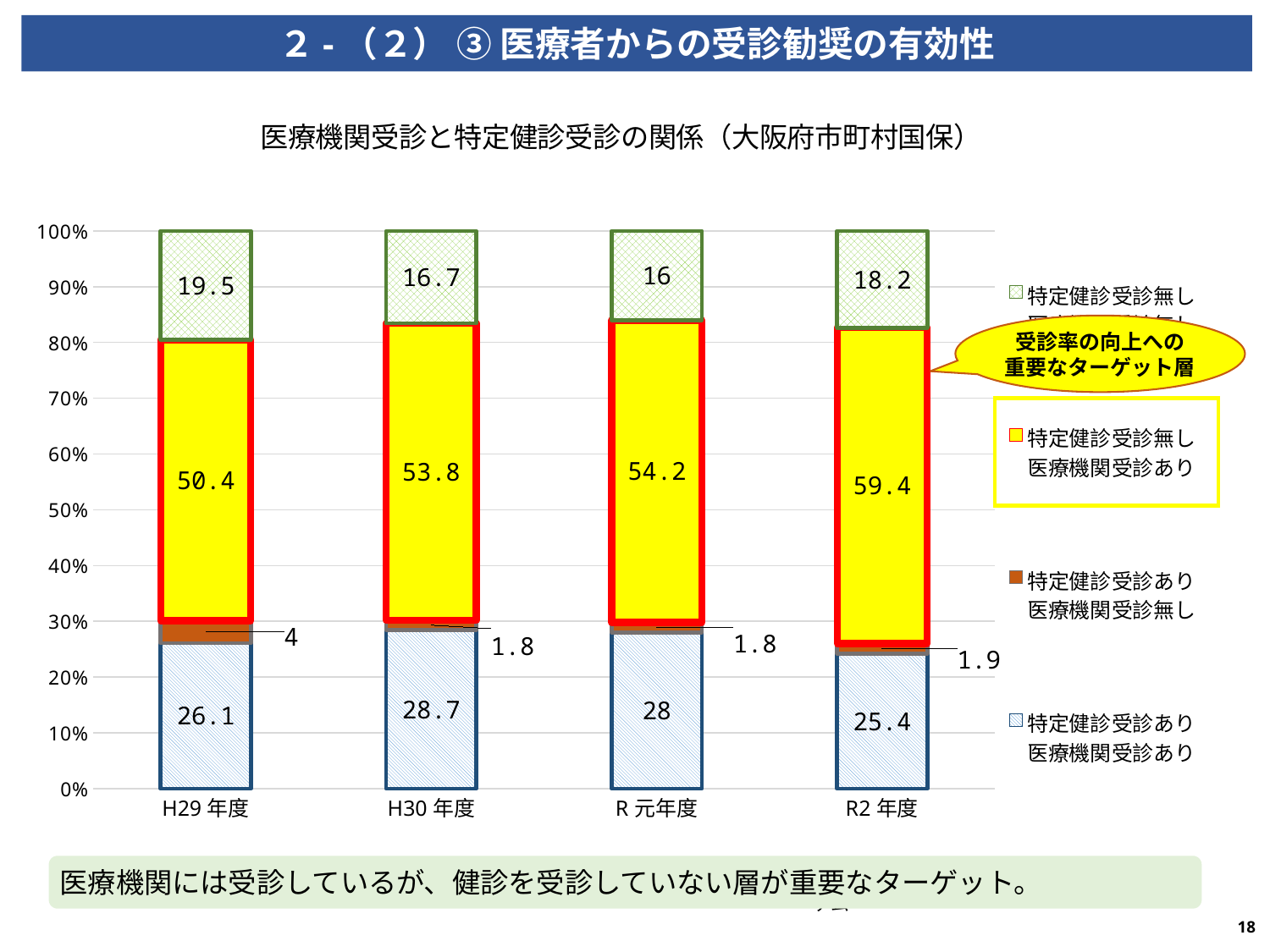
What is the value of the 特定健診受診あり 医療機関受診あり segment for H30 年度? 28.7 What is the value of the 特定健診受診無し 医療機関受診あり segment for R2 年度? 59.4 Which is larger: the 特定健診受診無し 医療機関受診無し value for H29 年度 or for R2 年度? H29 年度 How many fiscal-year categories are shown on the x axis? 4 What is the value of the top (特定健診受診無し 医療機関受診無し) segment for R 元年度? 16 What type of chart is shown on the slide? Stacked bar chart What is the difference between the 特定健診受診無し 医療機関受診あり values for R2 年度 and H29 年度? 9 In which fiscal year is the 特定健診受診無し 医療機関受診あり segment the largest? R2 年度 Does the 特定健診受診無し 医療機関受診あり segment rise or fall from H29 年度 to R2 年度? Rise In which fiscal year is the 特定健診受診あり 医療機関受診あり segment the smallest? R2 年度 How many series does the legend list? 4 What is the value of the 特定健診受診あり 医療機関受診無し segment for H29 年度? 4